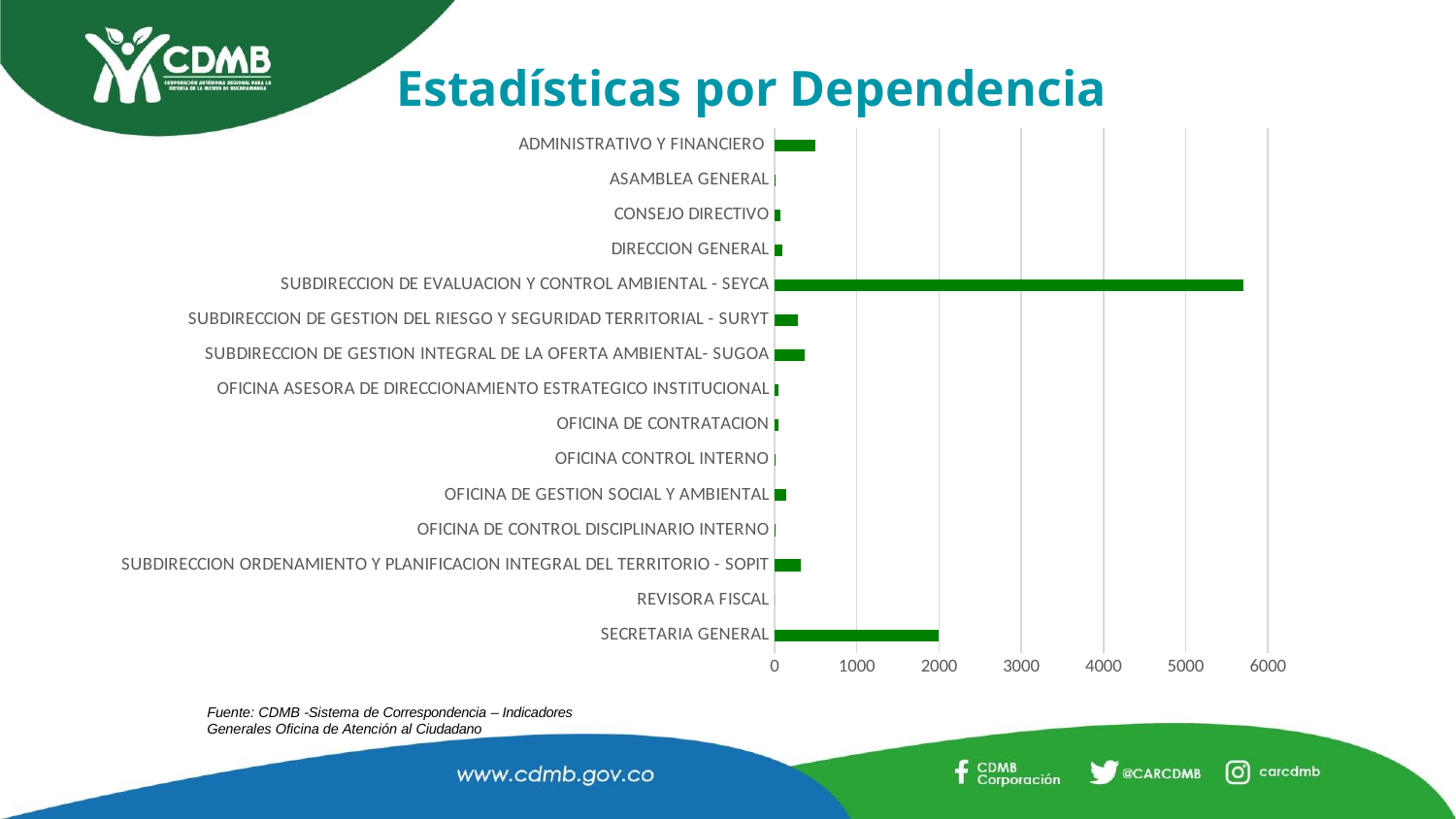
Is the value for SECRETARIA GENERAL greater or less than 1000? greater Which dependencia has the highest value on the chart? SUBDIRECCION DE EVALUACION Y CONTROL AMBIENTAL - SEYCA Is the value for SUBDIRECCION DE EVALUACION Y CONTROL AMBIENTAL - SEYCA greater or less than 6000? less Which has a larger value, SECRETARIA GENERAL or ADMINISTRATIVO Y FINANCIERO? SECRETARIA GENERAL Is the value for SUBDIRECCION DE GESTION INTEGRAL DE LA OFERTA AMBIENTAL- SUGOA greater or less than 1000? less How many dependencias (categories) are listed on the chart? 15 What is the title of the slide containing the chart? Estadísticas por Dependencia What kind of chart is shown on the slide? bar chart Which has a larger value, SUBDIRECCION DE EVALUACION Y CONTROL AMBIENTAL - SEYCA or SECRETARIA GENERAL? SUBDIRECCION DE EVALUACION Y CONTROL AMBIENTAL - SEYCA What is the highest value shown on the horizontal axis of the chart? 6000